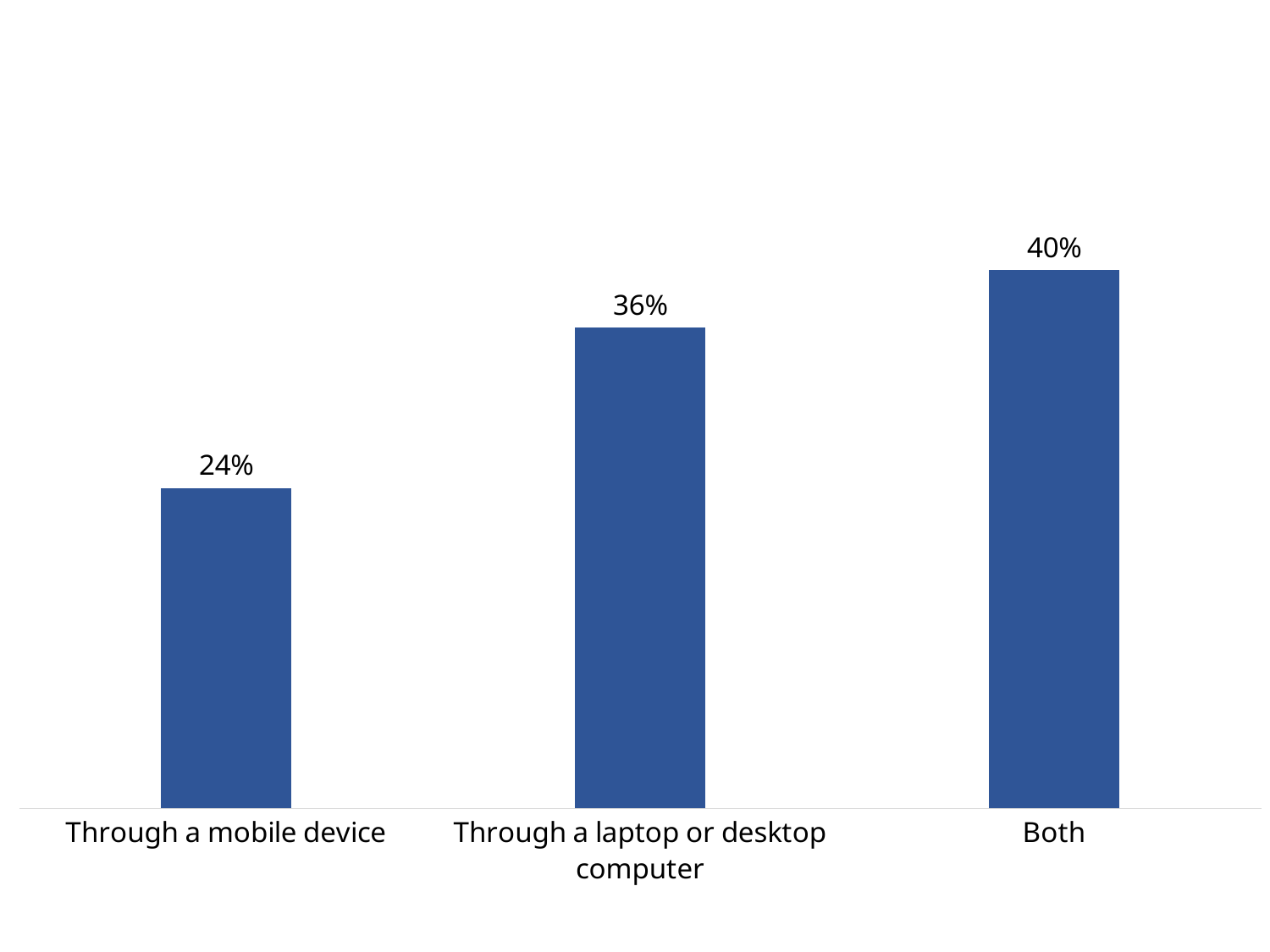
What is the value for "Through a laptop or desktop computer"? 36% What kind of chart is shown on the slide? Bar chart What is the value for "Both"? 40% Which is larger: the value for "Through a laptop or desktop computer" or the value for "Both"? Both What colour are the bars in the chart? Blue What is the value for "Through a mobile device"? 24% What is the difference between the values for "Through a laptop or desktop computer" and "Through a mobile device"? 12% Do the values rise or fall from left to right across the categories? Rise Which category has the highest value? Both What is the difference between the values for "Both" and "Through a mobile device"? 16% Which category has the lowest value? Through a mobile device How many categories are shown in the chart? 3